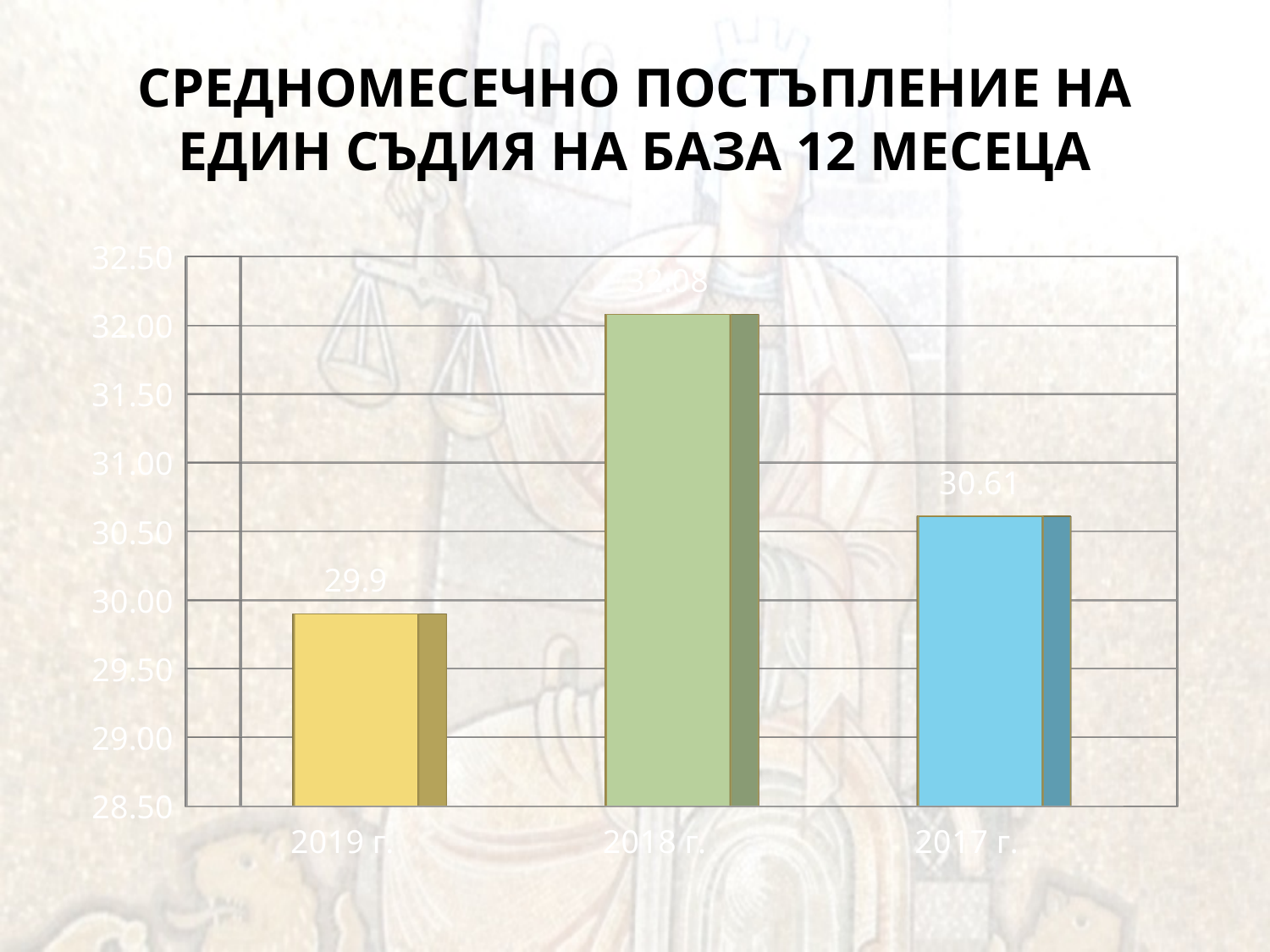
Which year has the highest value? 2018 г. What is the value for 2019 г.? 29.9 What is the title of the chart? СРЕДНОМЕСЕЧНО ПОСТЪПЛЕНИЕ НА ЕДИН СЪДИЯ НА БАЗА 12 МЕСЕЦА Which year has the lowest value? 2019 г. What is the difference between the values for 2018 г. and 2017 г.? 1.47 Which is larger, the value for 2017 г. or the value for 2019 г.? 2017 г. What is the value for 2018 г.? 32.08 How many categories are shown on the x axis? 3 What kind of chart is shown on the slide? bar chart Is the value for 2018 г. greater or less than 32.00? greater What is the value for 2017 г.? 30.61 What is the difference between the values for 2017 г. and 2019 г.? 0.71